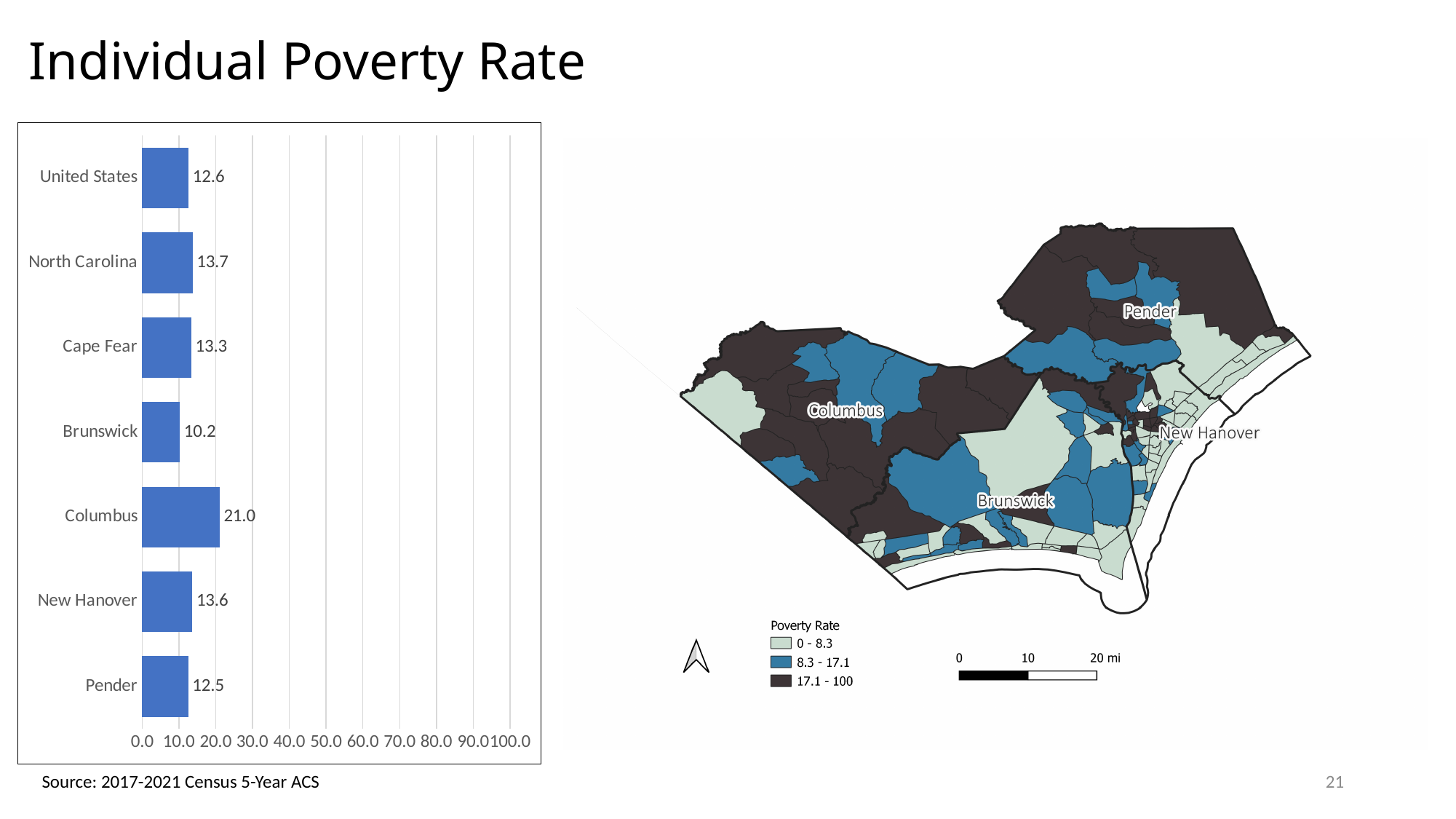
What is the maximum value shown on the x axis of the bar chart? 100.0 What is the difference between the poverty rates of Columbus and Brunswick? 10.8 Which has a higher poverty rate, Cape Fear or Pender? Cape Fear What is the individual poverty rate shown for the United States? 12.6 Which category has the highest individual poverty rate in the bar chart? Columbus What is the individual poverty rate shown for Brunswick? 10.2 Is the value for Columbus greater or less than 20.0? greater How many categories are shown in the bar chart? 7 Which category has the lowest individual poverty rate in the bar chart? Brunswick What kind of chart is used to show the individual poverty rates? Bar chart What is the difference between the poverty rates of North Carolina and the United States? 1.1 What is the individual poverty rate shown for Columbus? 21.0